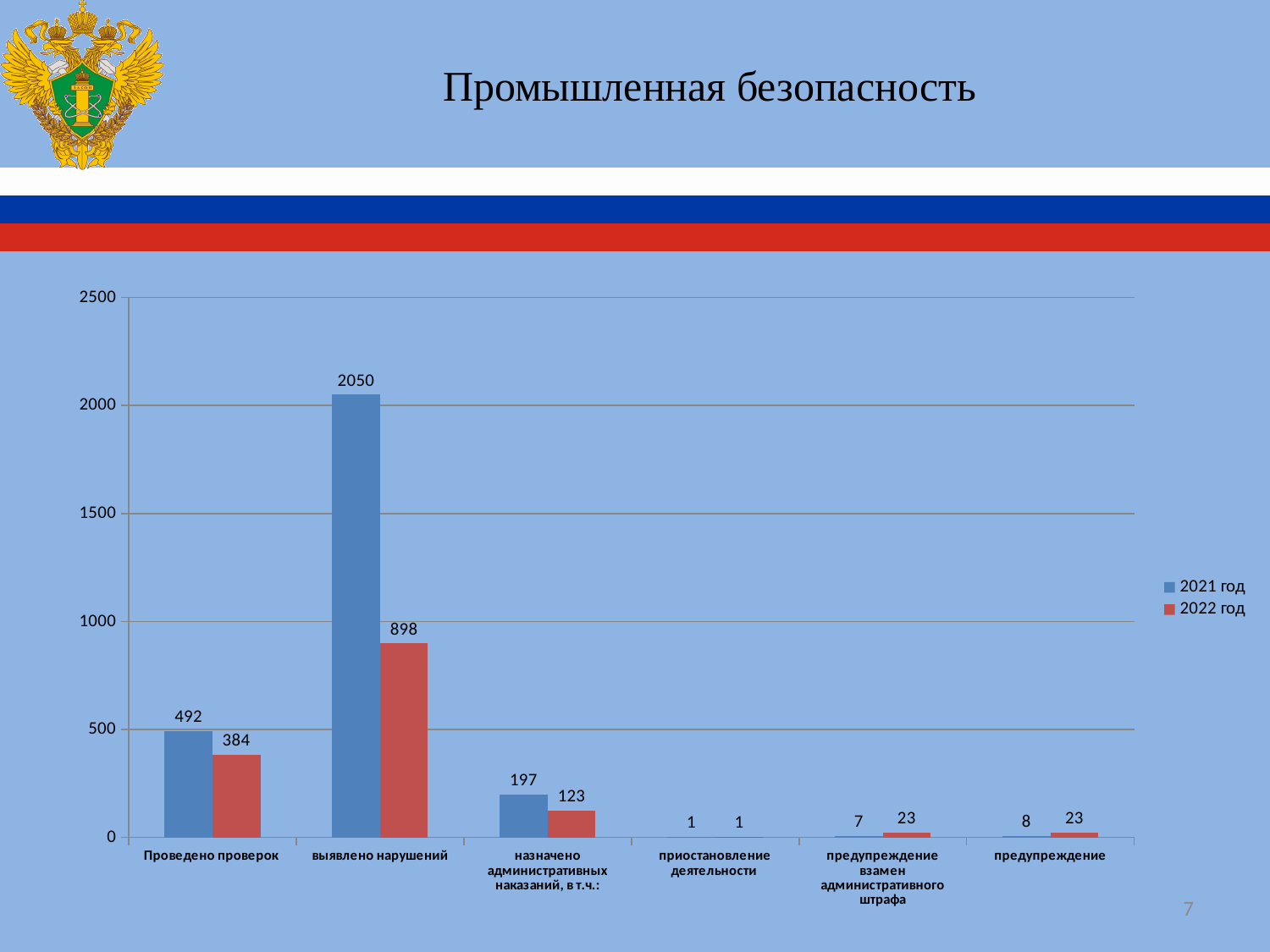
Which category has the highest value in the 2021 год series? выявлено нарушений What is the value for "выявлено нарушений" in the 2022 год series? 898 What is the value for "предупреждение взамен административного штрафа" in the 2022 год series? 23 What is the difference between the 2021 год and 2022 год values for "Проведено проверок"? 108 How many series does the legend list? 2 Which category has the lowest value in the 2022 год series? приостановление деятельности What is the difference between the 2021 год and 2022 год values for "выявлено нарушений"? 1152 How many categories are shown on the x axis? 6 What is the value for "назначено административных наказаний, в т.ч.:" in the 2021 год series? 197 What is the value for "Проведено проверок" in the 2021 год series? 492 What kind of chart is shown on the slide? bar chart Which is larger for "назначено административных наказаний, в т.ч.:": the 2021 год value or the 2022 год value? 2021 год